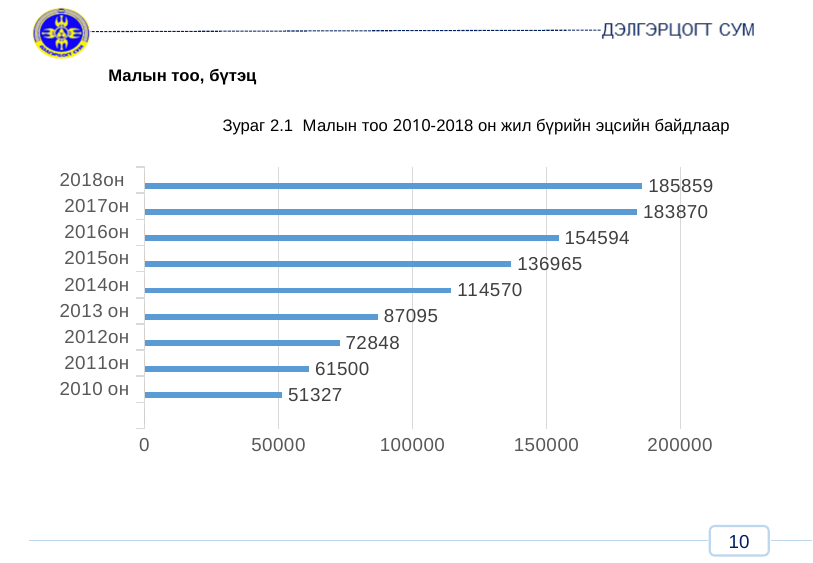
Which is larger, the value for 2013 он or the value for 2012он? 2013 он What is the value for 2018он? 185859 What is the value for 2014он? 114570 How many years are shown in the chart? 9 Is the value for 2015он greater or less than 150000? less What kind of chart is shown on the slide? bar chart What is the difference between the values for 2016он and 2015он? 17629 What is the difference between the values for 2018он and 2017он? 1989 Which year has the highest value? 2018он What is the title of the chart? Зураг 2.1 Малын тоо 2010-2018 он жил бүрийн эцсийн байдлаар Which year has the lowest value? 2010 он What is the value for 2010 он? 51327